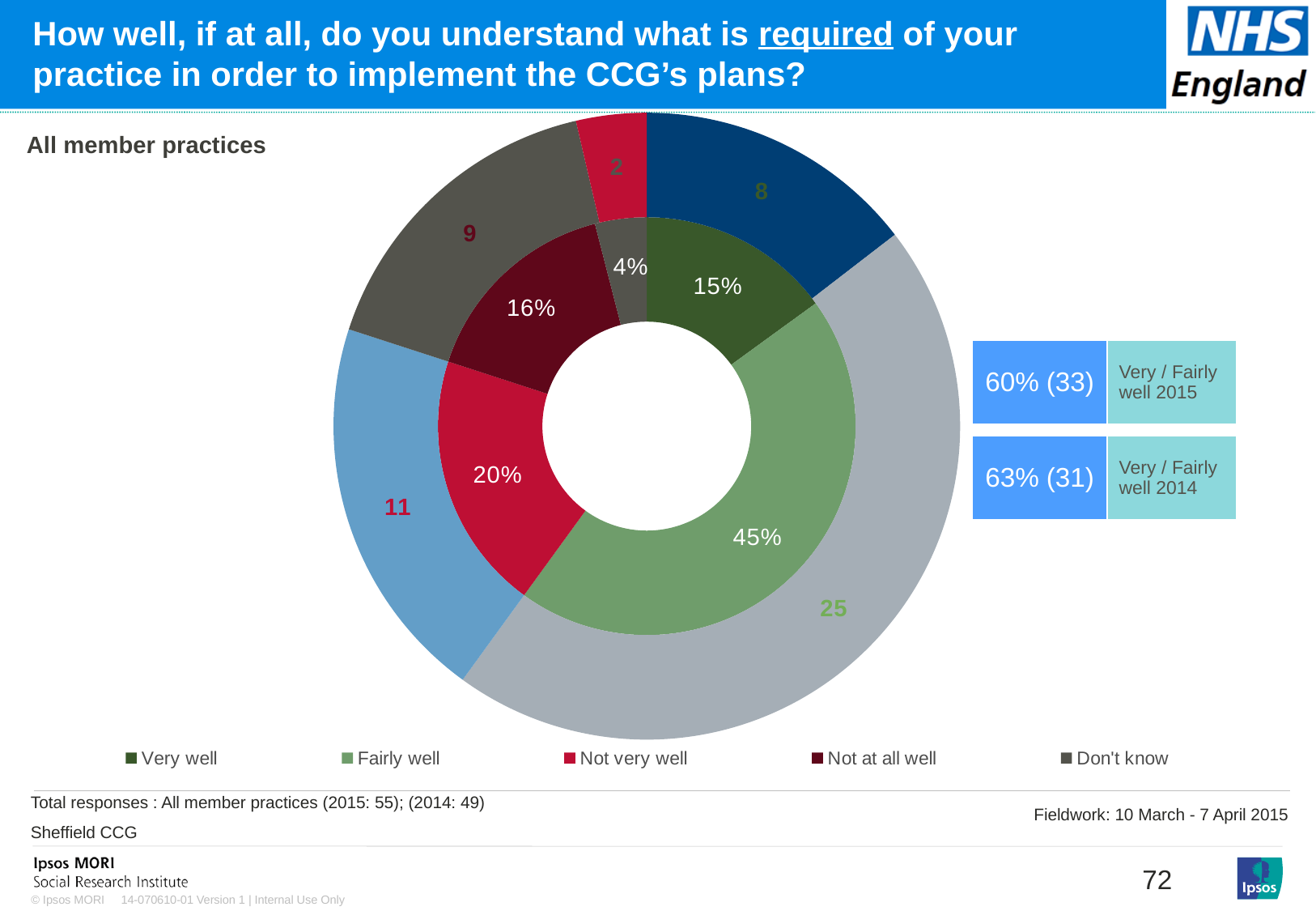
What percentage of member practices answered 'Very well'? 15% Which is larger, the share for 'Not very well' or the share for 'Not at all well'? Not very well What percentage of member practices answered 'Not at all well'? 16% What is the combined 'Very / Fairly well' figure shown for 2015? 60% (33) How many categories does the legend list? 5 What kind of chart is shown on the slide? Doughnut chart What percentage of member practices answered 'Don't know'? 4% What percentage of member practices answered 'Fairly well'? 45% Which response category has the smallest share of the inner ring? Don't know Which response category has the largest share of the inner ring? Fairly well What percentage of member practices answered 'Not very well'? 20% What is the difference in percentage points between 'Fairly well' and 'Very well'? 30